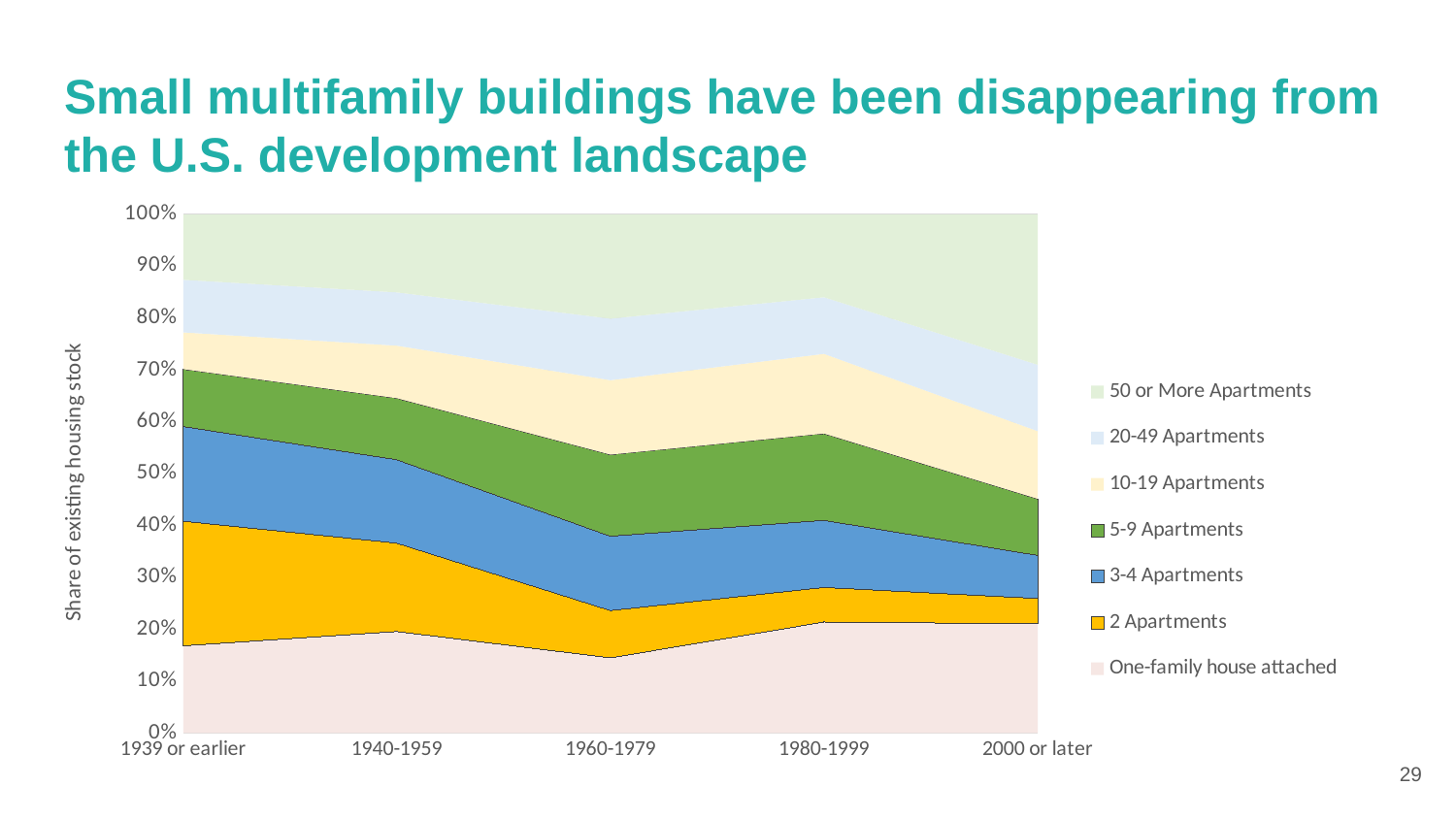
Is the share of 2 Apartments larger for 1939 or earlier or for 2000 or later? 1939 or earlier Is the share of One-family house attached for 1939 or earlier greater or less than 20%? less Does the share of 50 or More Apartments rise or fall from 1939 or earlier to 2000 or later? rise What kind of chart is shown on the slide? Stacked area chart Is the share of One-family house attached for 1960-1979 greater or less than 20%? less What is the label of the y axis? Share of existing housing stock Is the cumulative share up through the 3-4 Apartments band for 2000 or later greater or less than 40%? less How many construction periods are shown along the x axis? 5 Which legend entry is listed first (top of the legend)? 50 or More Apartments How many series does the legend list? 7 Which construction period has the largest share of 50 or More Apartments? 2000 or later